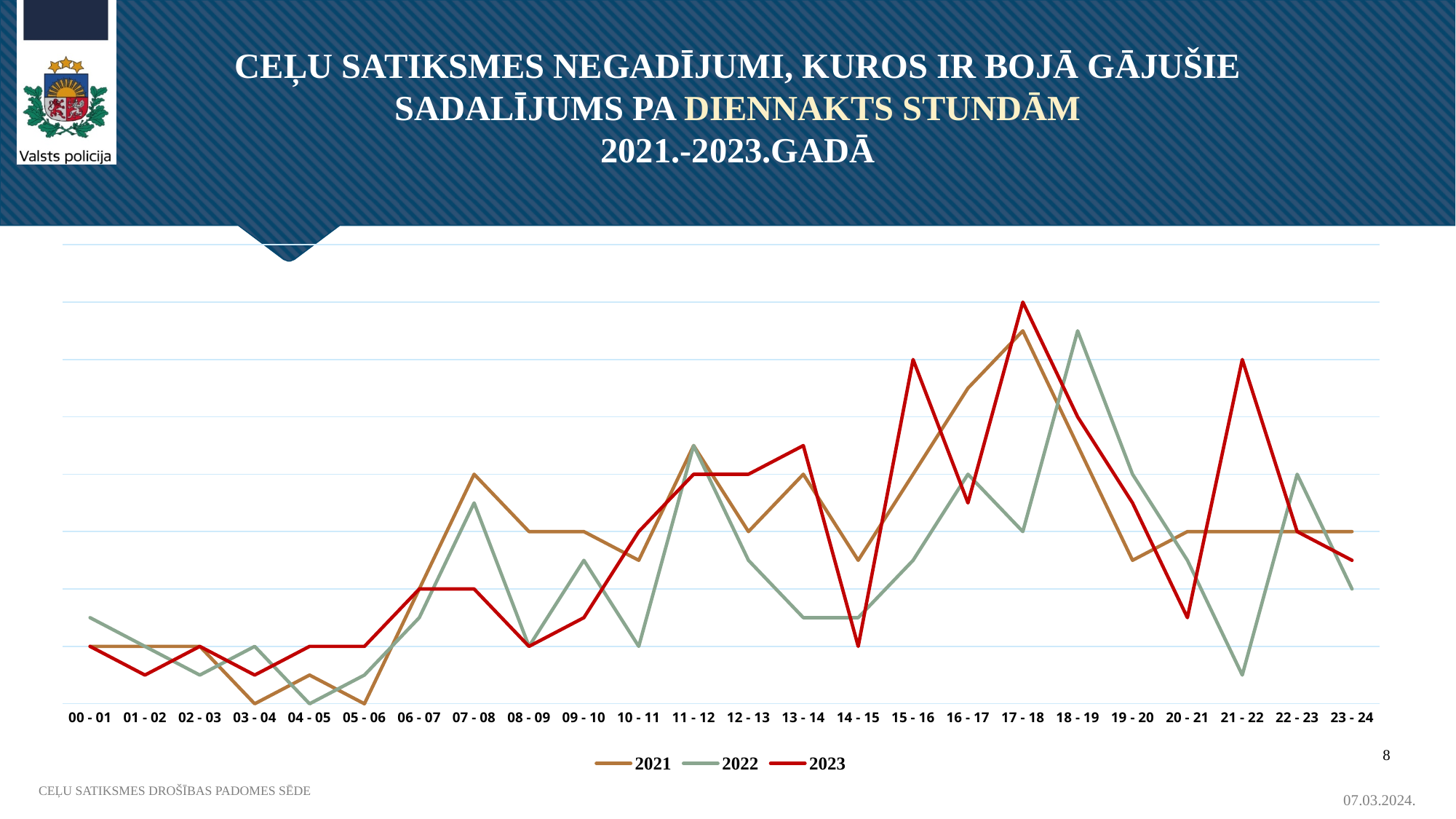
At 18 - 19, which series has the larger value, 2021 or 2022? 2022 What kind of chart is shown on the slide? line chart How many series does the legend list? 3 How many hour intervals are shown along the x axis? 24 In which hour interval does the 2023 series reach its highest value? 17 - 18 At 21 - 22, which series has the larger value, 2022 or 2023? 2023 Which series is drawn in red? 2023 At 15 - 16, which series has the larger value, 2022 or 2023? 2023 Which years are listed in the chart legend? 2021, 2022, 2023 In which hour interval does the 2022 series reach its highest value? 18 - 19 In which hour interval does the 2021 series reach its highest value? 17 - 18